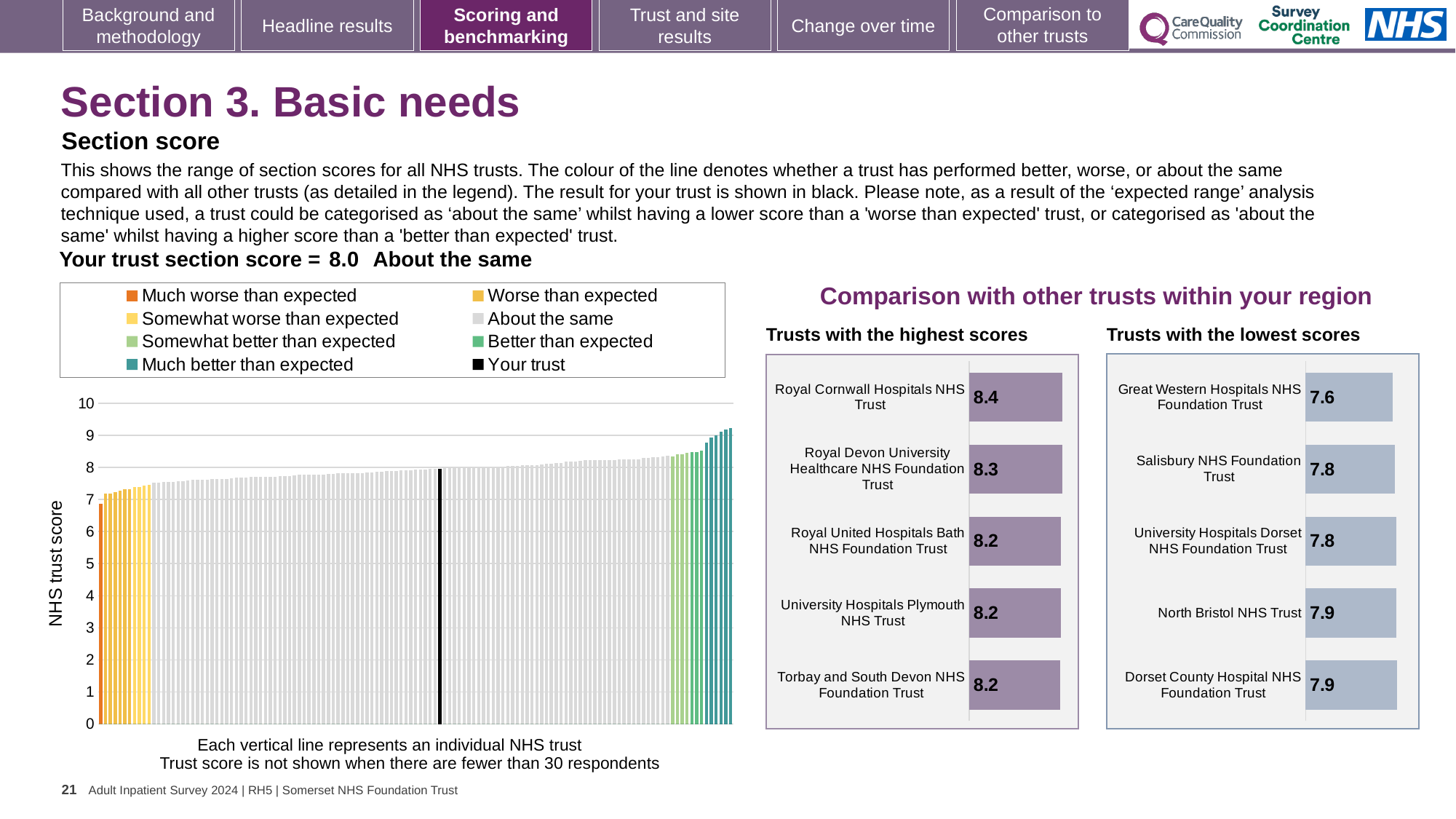
In the 'Trusts with the lowest scores' chart, which has the larger score: Great Western Hospitals NHS Foundation Trust or North Bristol NHS Trust? North Bristol NHS Trust In the 'Trusts with the highest scores' chart, what is the difference between the scores of Royal Cornwall Hospitals NHS Trust and Royal United Hospitals Bath NHS Foundation Trust? 0.2 In the 'Trusts with the lowest scores' chart, what is the score for Great Western Hospitals NHS Foundation Trust? 7.6 In the 'Trusts with the lowest scores' chart, what is the score for Salisbury NHS Foundation Trust? 7.8 In the 'Trusts with the lowest scores' chart, which trust has the lowest score? Great Western Hospitals NHS Foundation Trust How many trusts are listed in the 'Trusts with the lowest scores' chart? 5 How many entries does the legend of the main chart on the left list? 8 In the main chart of NHS trust scores on the left, what is the section score for your trust (the black line)? 8.0 In the main chart on the left, do the trust scores rise or fall from left to right along the x axis? Rise In the 'Trusts with the highest scores' chart, what is the score for Royal Cornwall Hospitals NHS Trust? 8.4 In the 'Trusts with the highest scores' chart, which trust has the highest score? Royal Cornwall Hospitals NHS Trust What kind of chart is the main chart on the left showing NHS trust scores? Bar chart